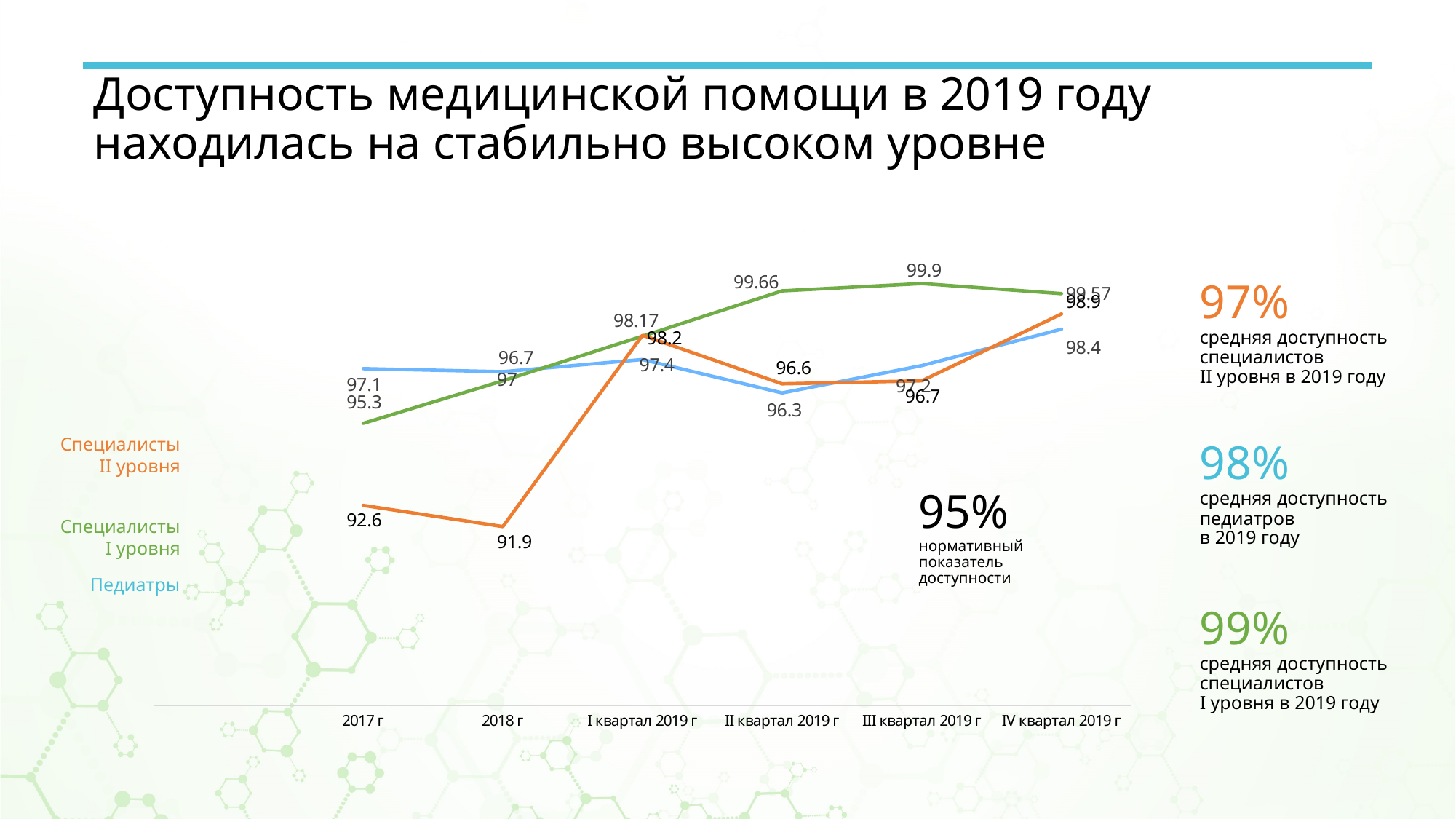
What is the value for Педиатры in IV квартал 2019 г? 98.4 What is the value for Специалисты I уровня in II квартал 2019 г? 99.66 How many categories are shown along the x axis of the chart? 6 In 2017 г, which series has the larger value: Педиатры or Специалисты I уровня? Педиатры Does the Специалисты II уровня series rise or fall from 2017 г to 2018 г? fall How many series does the chart's legend list? 3 In which period does the Специалисты II уровня series have its lowest value? 2018 г What kind of chart is shown on the slide? line chart What is the value for Специалисты II уровня in 2018 г? 91.9 What normative accessibility value is marked by the dashed line on the chart? 95% In which period does the Специалисты I уровня series reach its highest value? III квартал 2019 г What is the difference between the Специалисты II уровня values for 2017 г and 2018 г? 0.7